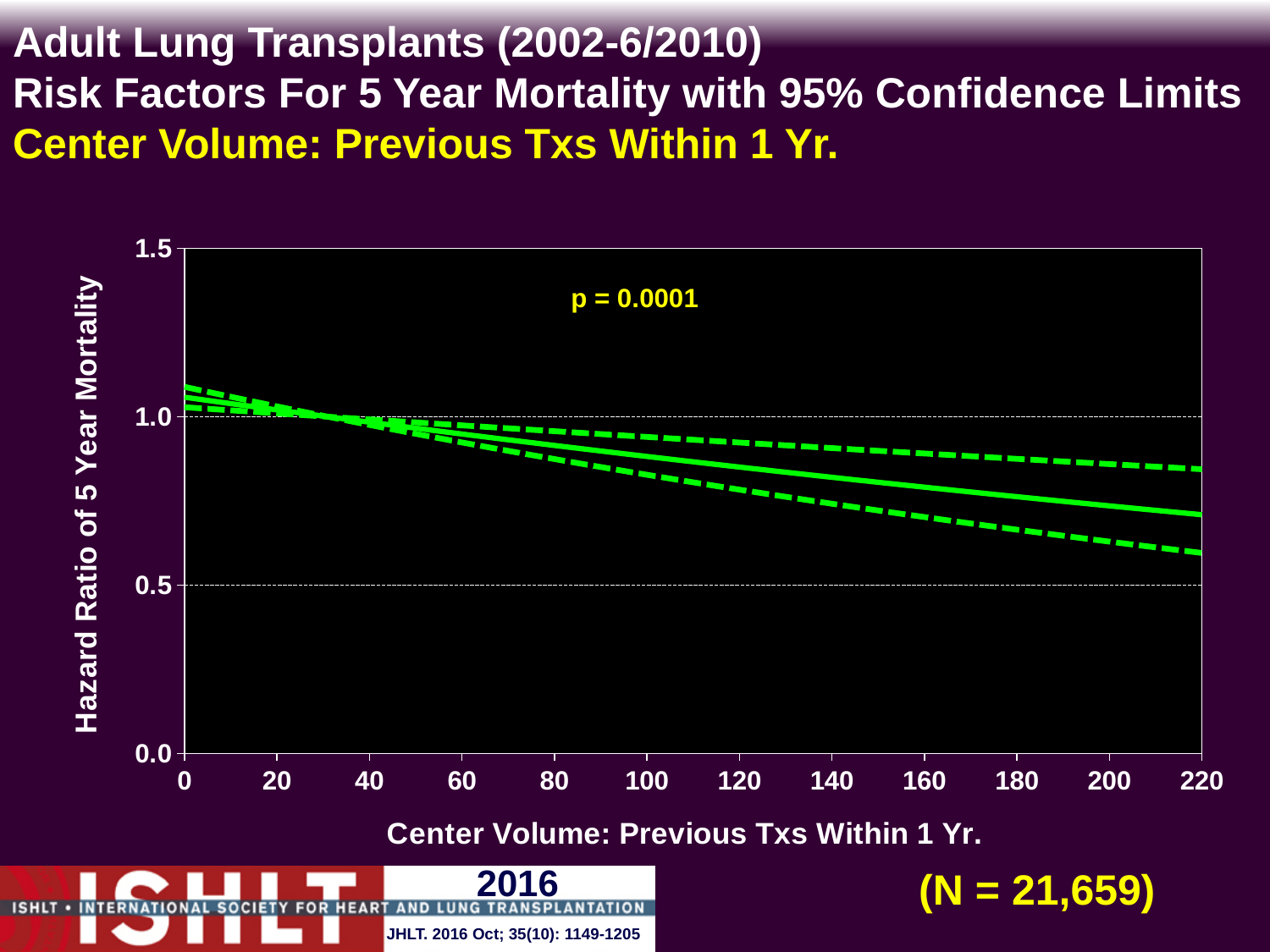
Is the upper confidence limit (upper dashed line) at a center volume of 200 greater or less than 1.0? less Is the lower confidence limit (lower dashed line) at a center volume of 220 greater or less than 0.5? greater At a center volume of 220, which is larger: the upper dashed confidence limit or the lower dashed confidence limit? upper dashed confidence limit Is the hazard ratio (solid line) at a center volume of 100 greater or less than 1.0? less What p-value is printed on the chart? p = 0.0001 What is the maximum value shown on the x axis? 220 How many lines are plotted on the chart? 3 What kind of chart is shown on the slide? line chart Does the solid hazard ratio line rise or fall as center volume increases along the x axis? fall